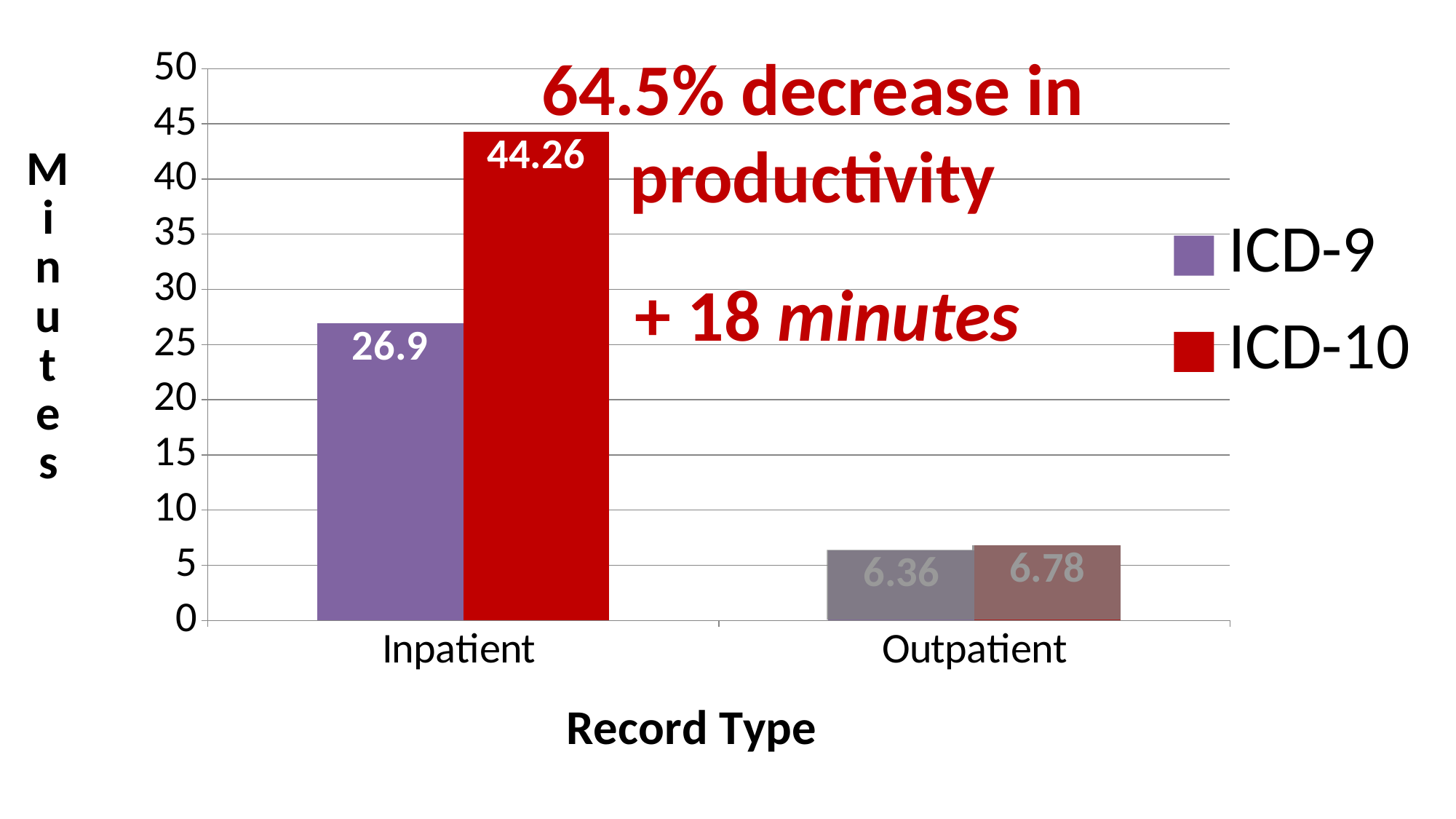
What is the ICD-9 value for Inpatient? 26.9 How many record type categories are shown on the x axis? 2 What kind of chart is shown on the slide? bar chart What is the difference between the ICD-10 and ICD-9 values for Inpatient? 17.36 Which bar has the lowest value on the chart? ICD-9 Outpatient Which is larger for Inpatient, the ICD-9 value or the ICD-10 value? ICD-10 What is the ICD-10 value for Outpatient? 6.78 What is the ICD-9 value for Outpatient? 6.36 How many series does the legend list? 2 Which bar has the highest value on the chart? ICD-10 Inpatient Is the ICD-10 value for Inpatient greater or less than 40? greater What is the ICD-10 value for Inpatient? 44.26